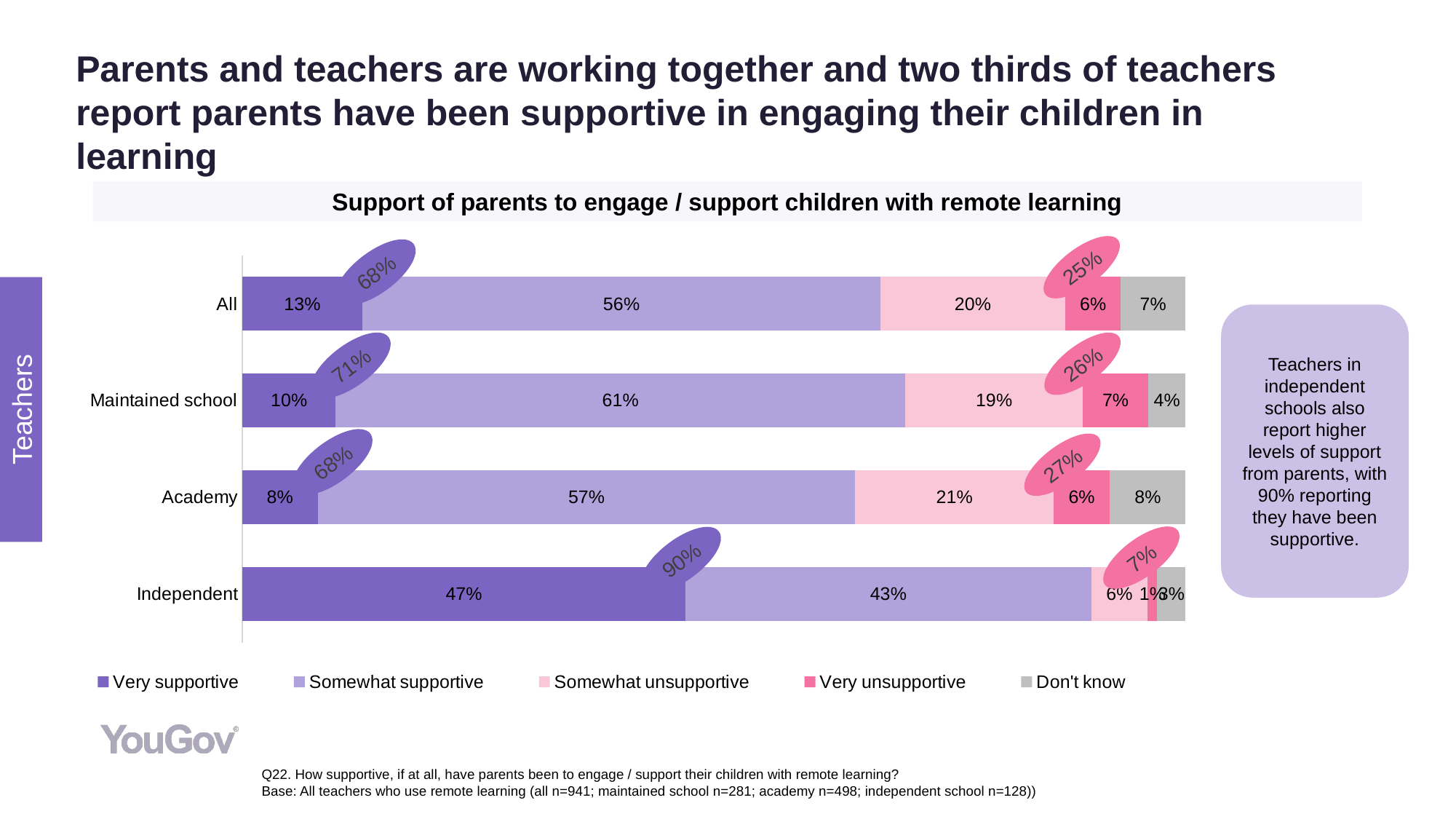
What is the 'Don't know' value for Academy? 8% What is the difference between the 'Somewhat supportive' values for Maintained school and Academy? 4% What is the 'Somewhat supportive' value for Maintained school? 61% How many series does the legend list? 5 How many categories (bars) are shown in the chart? 4 What is the title of the chart? Support of parents to engage / support children with remote learning What is the 'Somewhat unsupportive' value for All teachers? 20% Which is larger: the 'Very unsupportive' value for Maintained school or for Academy? Maintained school What kind of chart is shown on the slide? Stacked bar chart Which category has the highest 'Very supportive' value? Independent What percentage of Independent school teachers said parents were very supportive? 47% Which category has the lowest 'Very supportive' value? Academy